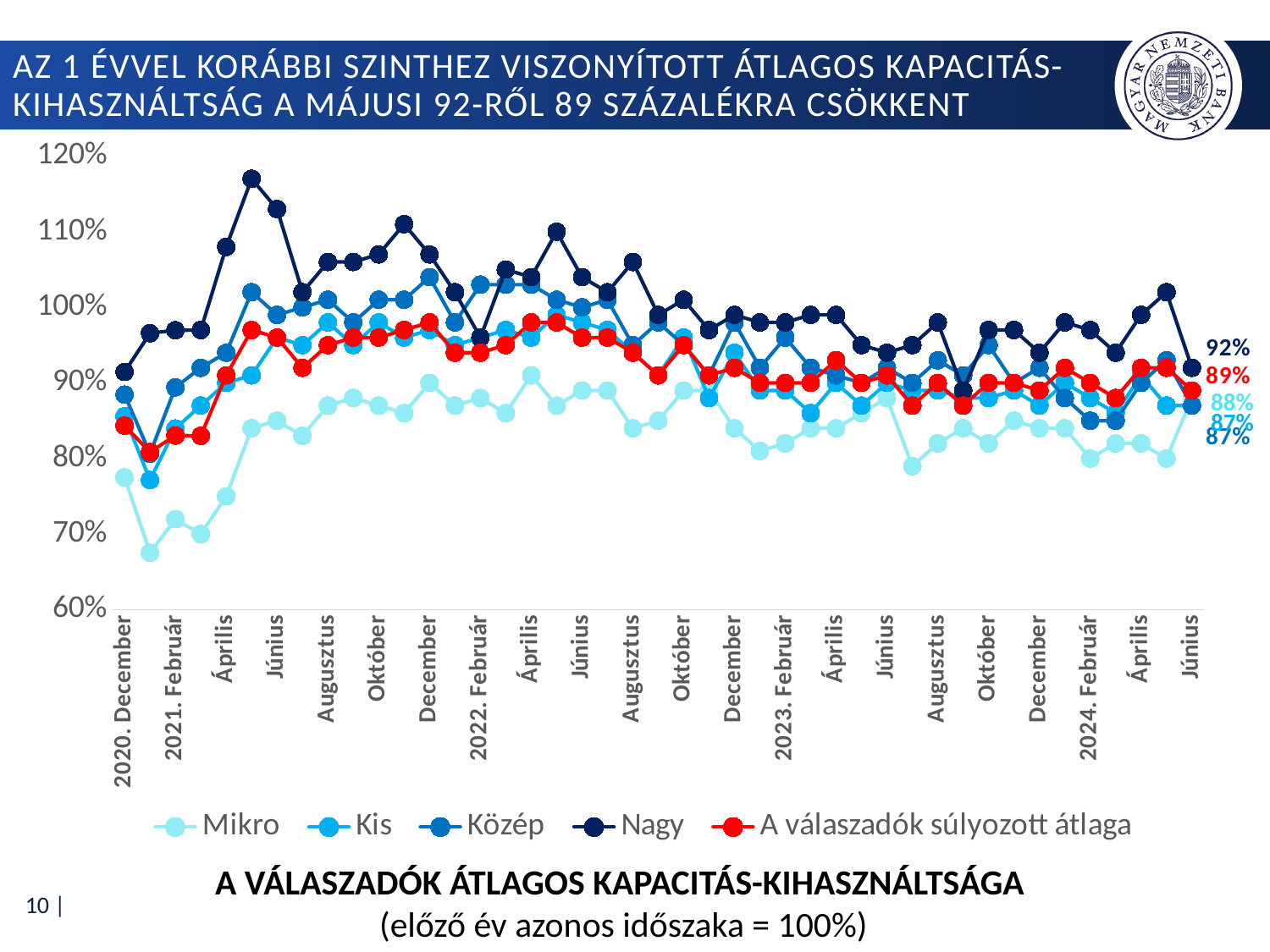
What is the difference between the final values of Nagy (92%) and A válaszadók súlyozott átlaga (89%)? 3 percentage points What kind of chart is shown on the slide? line chart At 2020. December, which series is higher: Nagy or Mikro? Nagy Which series is drawn in red? A válaszadók súlyozott átlaga Is the value for Nagy at 2021 Április greater or less than 100%? greater What is the title printed below the chart? A VÁLASZADÓK ÁTLAGOS KAPACITÁS-KIHASZNÁLTSÁGA (előző év azonos időszaka = 100%) How many series does the legend list? 5 Is the value for Mikro at 2021. Február greater or less than 80%? less Does the Mikro series rise or fall between 2020. December and 2021. Február? fall Which series has the highest value at the last point of the chart (2024 Június)? Nagy What is the value of the Nagy series at the last point (2024 Június)? 92% What is the value of 'A válaszadók súlyozott átlaga' at the last point (2024 Június)? 89%